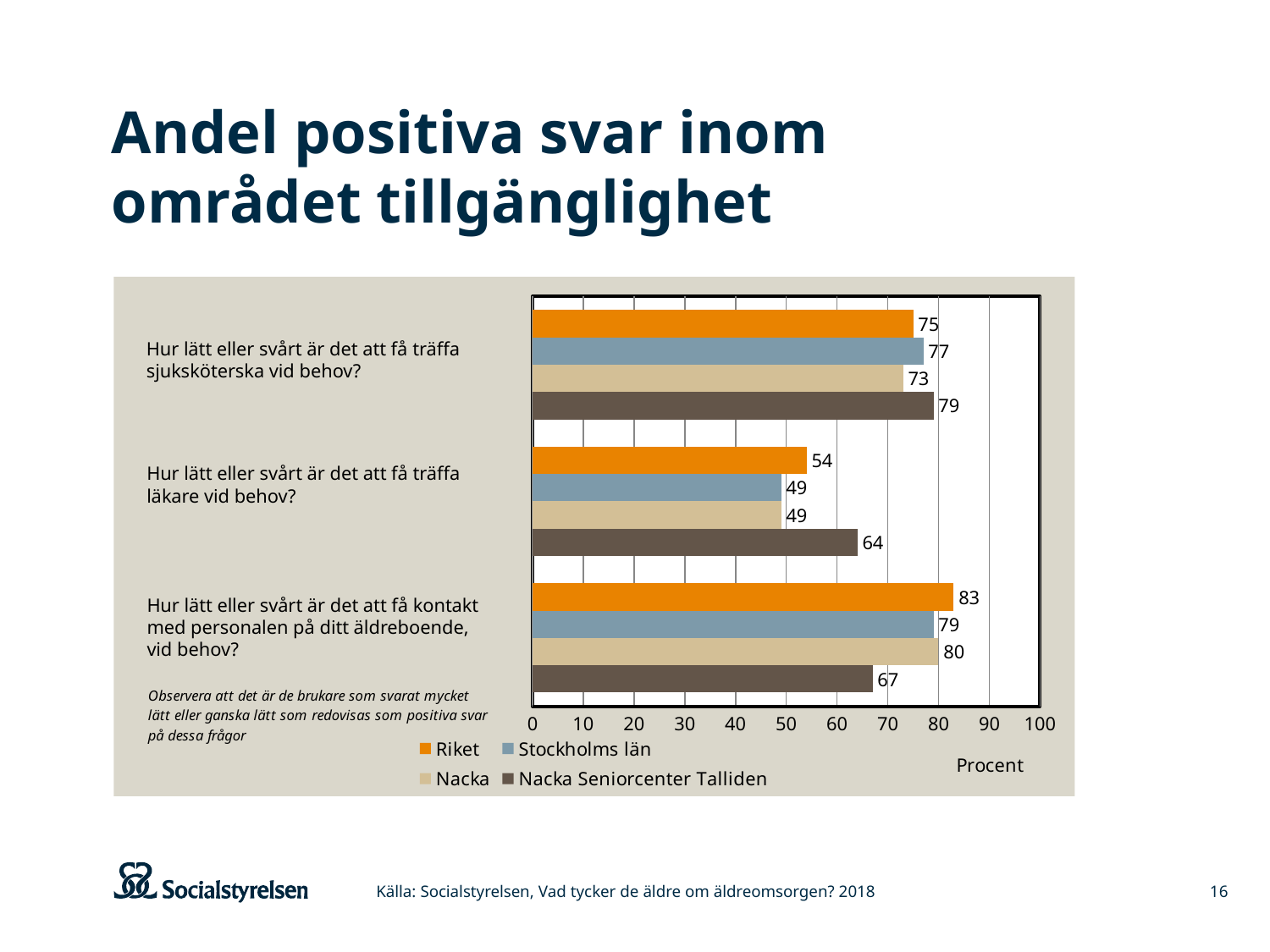
What is the label on the horizontal axis of the chart? Procent What is the value for Nacka Seniorcenter Talliden on the question "Hur lätt eller svårt är det att få träffa sjuksköterska vid behov?" 79 How many series does the legend list? 4 Is the value for Nacka on the question "Hur lätt eller svårt är det att få träffa läkare vid behov?" greater or less than 50? less What kind of chart is shown on the slide? Bar chart What is the value for Riket on the question "Hur lätt eller svårt är det att få träffa läkare vid behov?" 54 What is the value for Stockholms län on the question "Hur lätt eller svårt är det att få kontakt med personalen på ditt äldreboende, vid behov?" 79 Which is larger on the question "Hur lätt eller svårt är det att få träffa sjuksköterska vid behov?": Stockholms län or Nacka? Stockholms län What is the difference between Riket and Nacka Seniorcenter Talliden on the question "Hur lätt eller svårt är det att få kontakt med personalen på ditt äldreboende, vid behov?" 16 Which series has the highest value on the question "Hur lätt eller svårt är det att få träffa läkare vid behov?" Nacka Seniorcenter Talliden How many questions (categories) are shown on the chart? 3 Which series has the lowest value on the question "Hur lätt eller svårt är det att få kontakt med personalen på ditt äldreboende, vid behov?" Nacka Seniorcenter Talliden